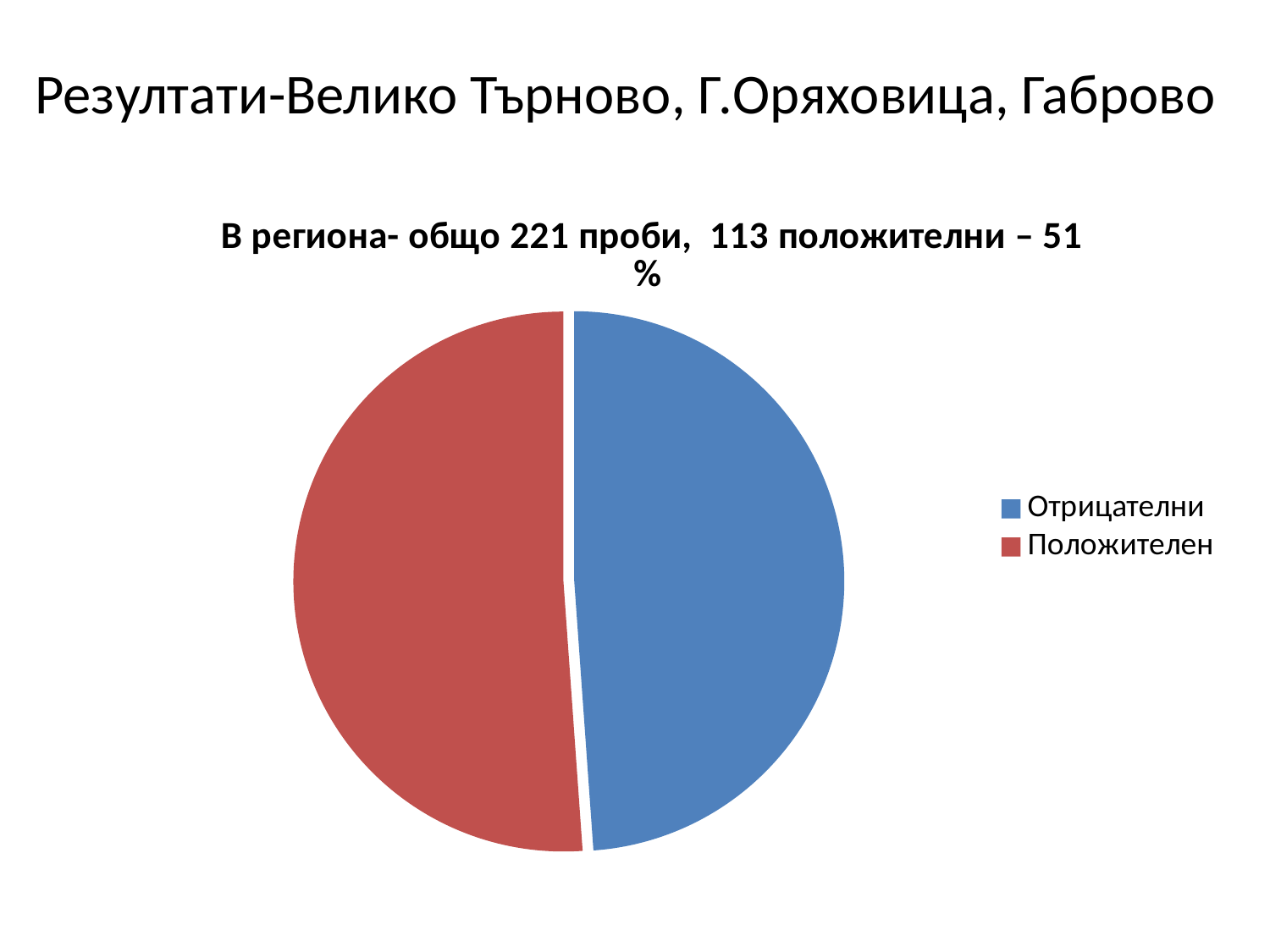
What share of the pie does the Положителен slice represent, as stated in the chart title? 51 % Which colour represents Отрицателни in the pie chart? blue According to the chart title, how many samples were positive (положителни)? 113 What kind of chart is shown on the slide? pie chart How many slices does the pie chart have? 2 How many entries does the legend of the pie chart list? 2 According to the chart title, how many samples (проби) were tested in total in the region? 221 Which colour represents Положителен in the pie chart? red